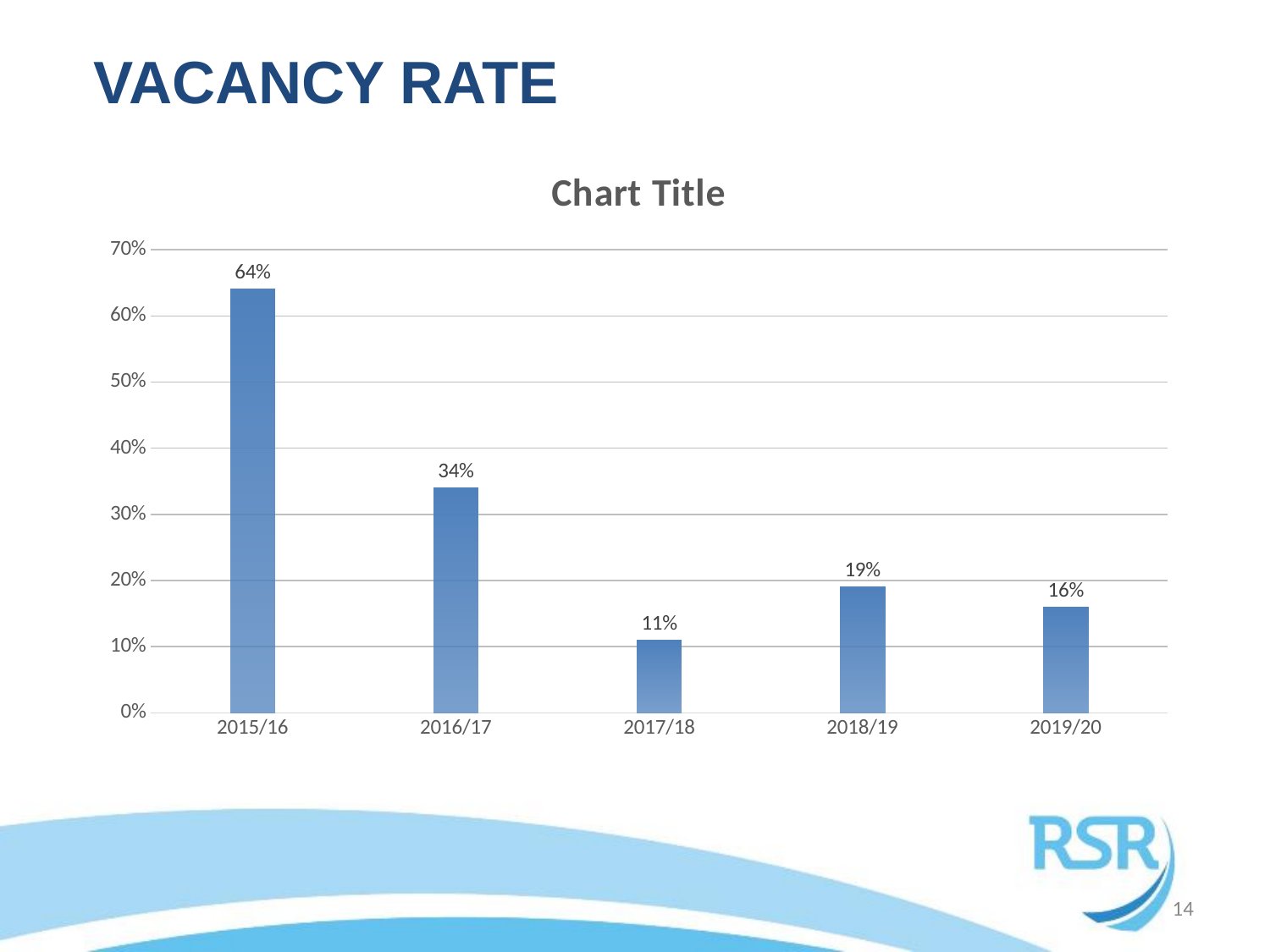
What kind of chart is shown on the slide? Bar chart Which year has the highest vacancy rate? 2015/16 What is the difference between the vacancy rates for 2018/19 and 2019/20? 3% Which year has the lowest vacancy rate? 2017/18 Which is larger, the vacancy rate for 2018/19 or for 2019/20? 2018/19 What is the title of the slide? VACANCY RATE What is the vacancy rate for 2019/20? 16% What is the vacancy rate for 2017/18? 11% What is the difference between the vacancy rates for 2015/16 and 2016/17? 30% How many years are shown on the chart? 5 Is the vacancy rate for 2016/17 greater or less than 30%? greater What is the vacancy rate for 2015/16? 64%